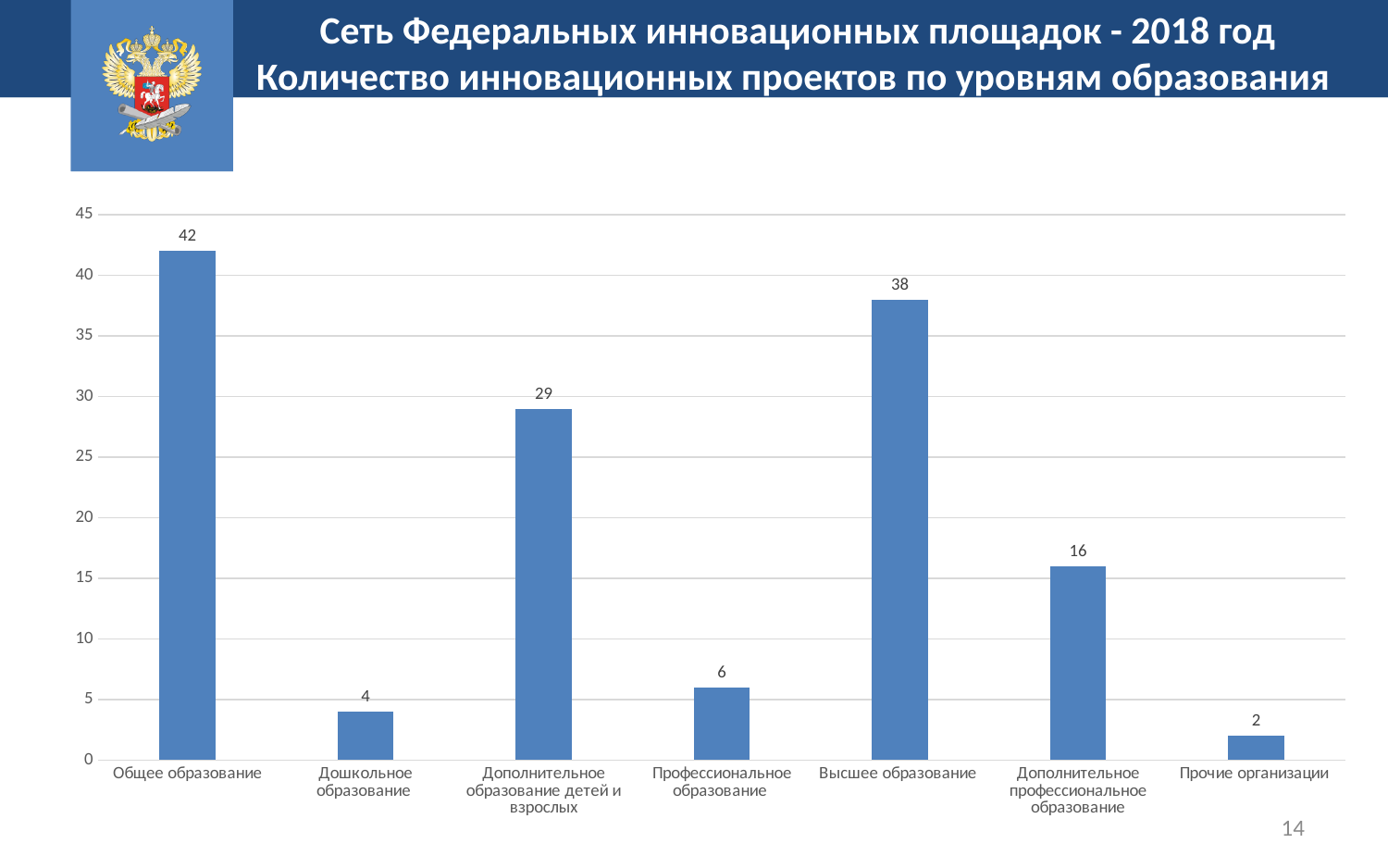
How many categories are shown on the chart? 7 What is the value for Прочие организации? 2 Which is larger: the value for Дополнительное образование детей и взрослых or the value for Дополнительное профессиональное образование? Дополнительное образование детей и взрослых What is the value for Дополнительное профессиональное образование? 16 What is the difference between the values for Дошкольное образование and Профессиональное образование? 2 What is the value for Высшее образование? 38 Which category has the highest value? Общее образование What kind of chart is shown on the slide? bar chart What is the value for Общее образование? 42 What is the difference between the values for Общее образование and Высшее образование? 4 Which category has the lowest value? Прочие организации Is the value for Профессиональное образование greater or less than 10? less